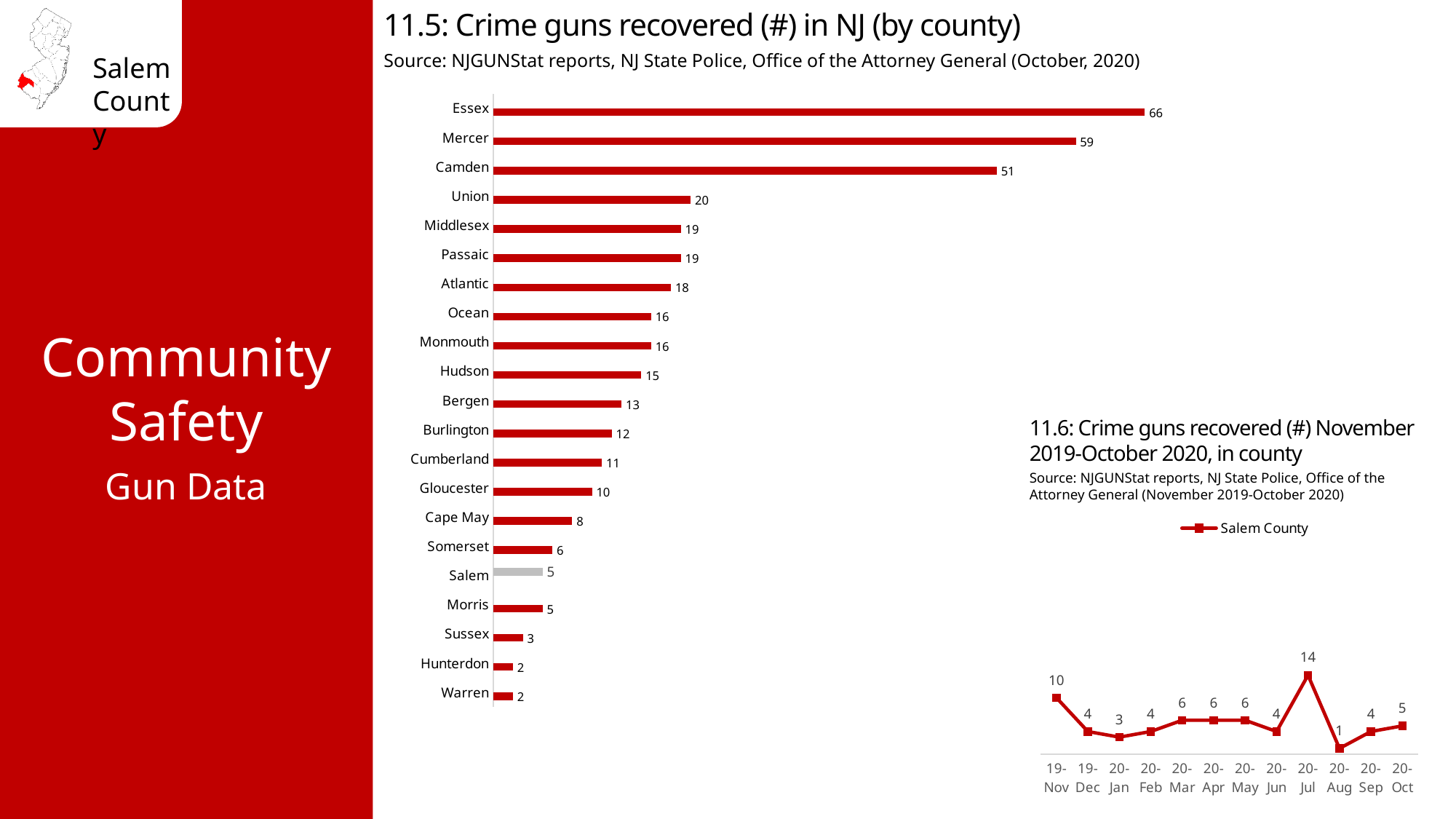
In chart 11.6, how many series does the legend list? 1 In chart 11.5, how many counties are shown? 21 In chart 11.5, which county has the highest number of crime guns recovered? Essex In chart 11.6, what is the difference between the values for 19-Nov and 19-Dec? 6 In chart 11.6, which month has the lowest value? 20-Aug In chart 11.5 (Crime guns recovered in NJ by county), how many crime guns were recovered in Essex? 66 In chart 11.5, how many crime guns were recovered in Salem? 5 In chart 11.5, which has a larger value, Union or Gloucester? Union In chart 11.6 (Crime guns recovered November 2019-October 2020, in county), what is the value for 20-Jul? 14 In chart 11.6, what is the name of the series shown in the legend? Salem County What type of chart is chart 11.5? Bar chart In chart 11.5, what is the difference between the values for Mercer and Camden? 8